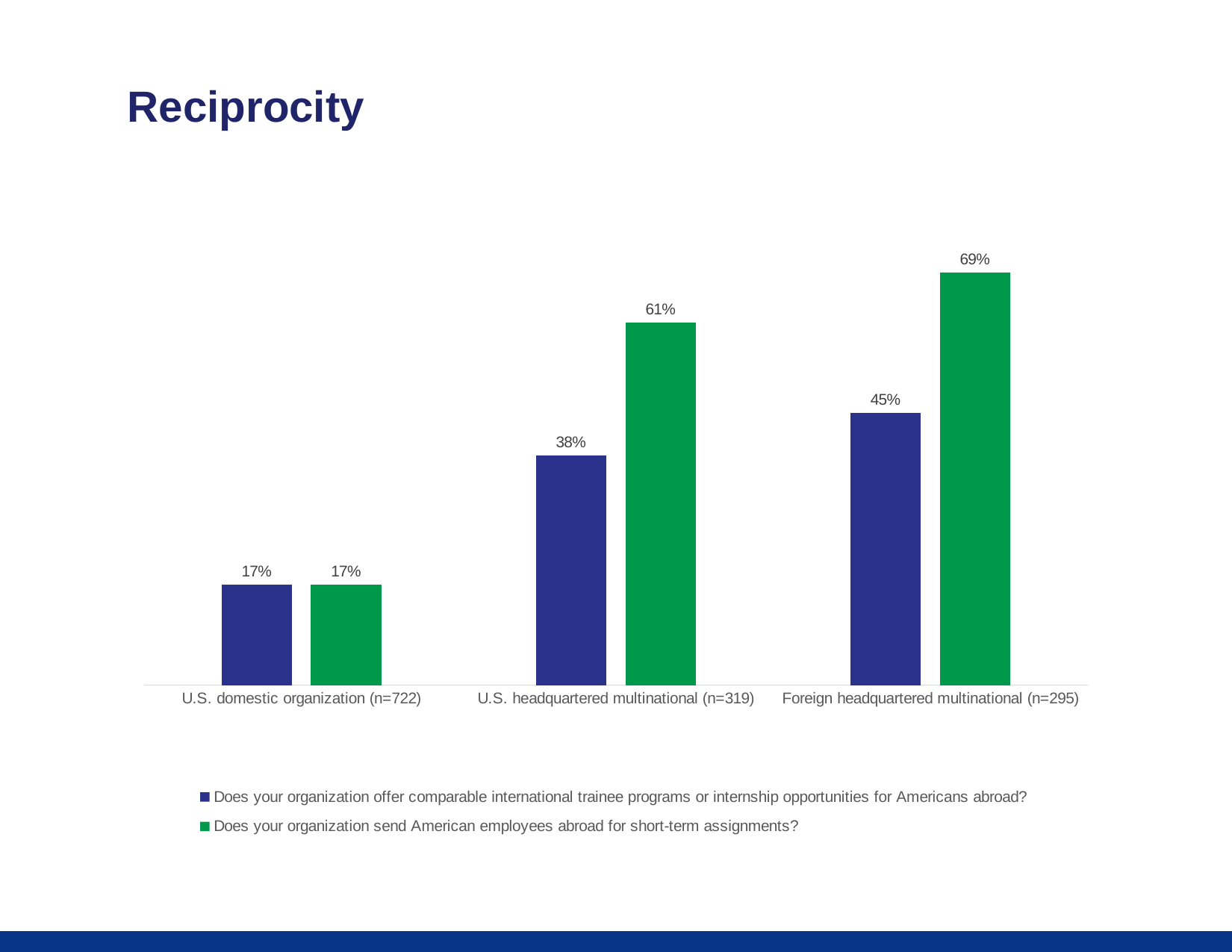
Which organization type has the highest percentage sending American employees abroad for short-term assignments? Foreign headquartered multinational (n=295) What percentage of U.S. domestic organizations (n=722) send American employees abroad for short-term assignments? 17% For U.S. headquartered multinationals, which is larger: the percentage offering comparable international trainee programs or the percentage sending American employees abroad for short-term assignments? Sending American employees abroad for short-term assignments How many series does the legend list? 2 What percentage of foreign headquartered multinationals (n=295) offer comparable international trainee programs or internship opportunities for Americans abroad? 45% What is the difference between U.S. headquartered multinationals and U.S. domestic organizations in the percentage offering comparable international trainee programs or internship opportunities for Americans abroad? 21% Which organization type has the lowest percentage offering comparable international trainee programs or internship opportunities for Americans abroad? U.S. domestic organization (n=722) How many organization types are shown on the x axis? 3 What colour are the bars for the series about sending American employees abroad for short-term assignments? Green What is the difference between the percentage of foreign headquartered multinationals that send American employees abroad for short-term assignments and the percentage that offer comparable international trainee programs? 24% What percentage of U.S. headquartered multinationals (n=319) send American employees abroad for short-term assignments? 61% What kind of chart is shown on the slide? Bar chart